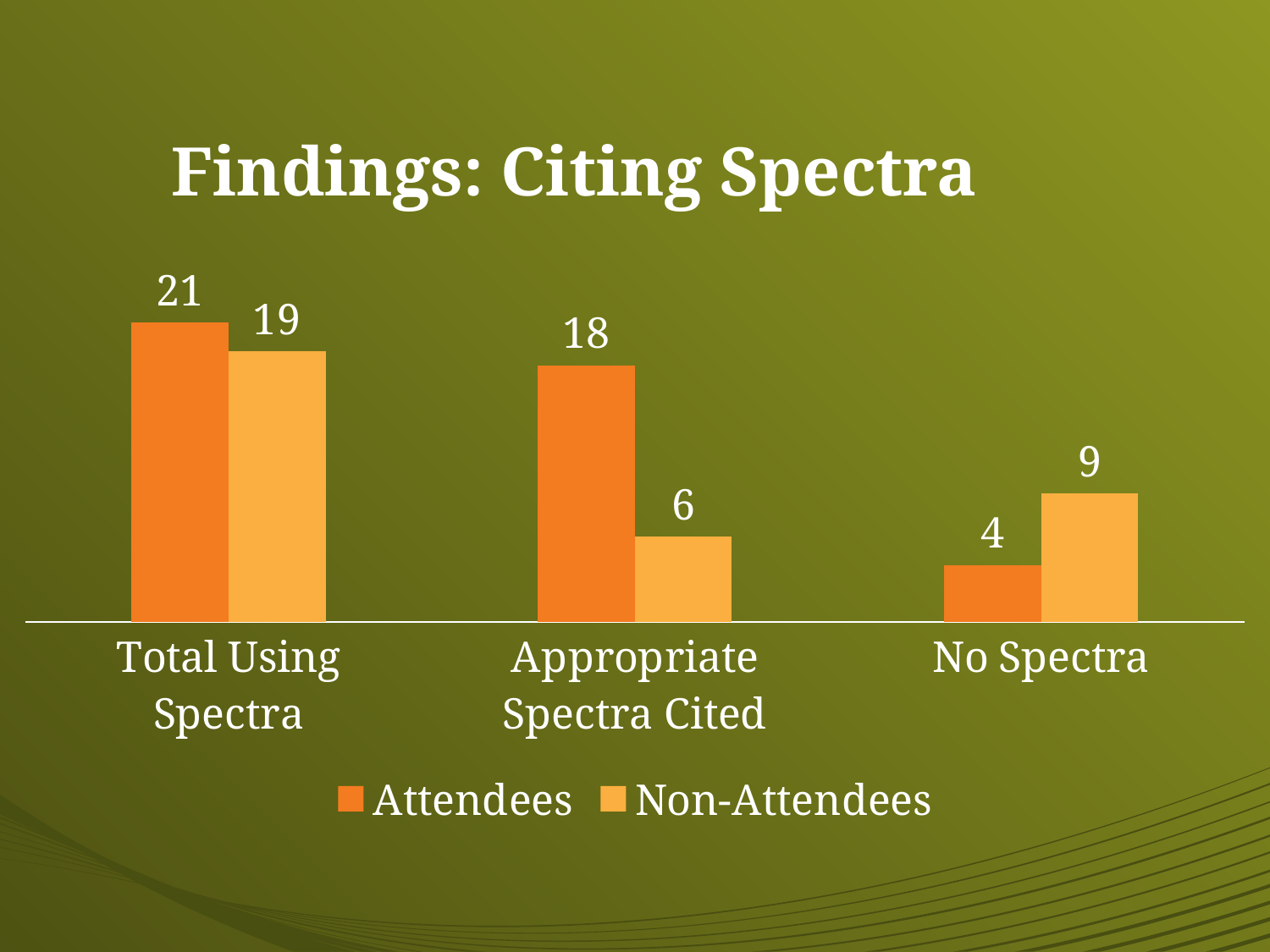
What kind of chart is shown on the slide? Bar chart In the No Spectra category, which series has the larger value, Attendees or Non-Attendees? Non-Attendees What is the title of the slide? Findings: Citing Spectra Which category has the highest value for Attendees? Total Using Spectra What is the value for Attendees in the Total Using Spectra category? 21 What is the difference between Attendees and Non-Attendees in the Appropriate Spectra Cited category? 12 How many categories are shown on the x axis? 3 What is the value for Non-Attendees in the No Spectra category? 9 How many series does the legend list? 2 Do the Attendees values rise or fall from left to right across the categories? Fall What is the value for Non-Attendees in the Appropriate Spectra Cited category? 6 Which category has the lowest value for Non-Attendees? Appropriate Spectra Cited